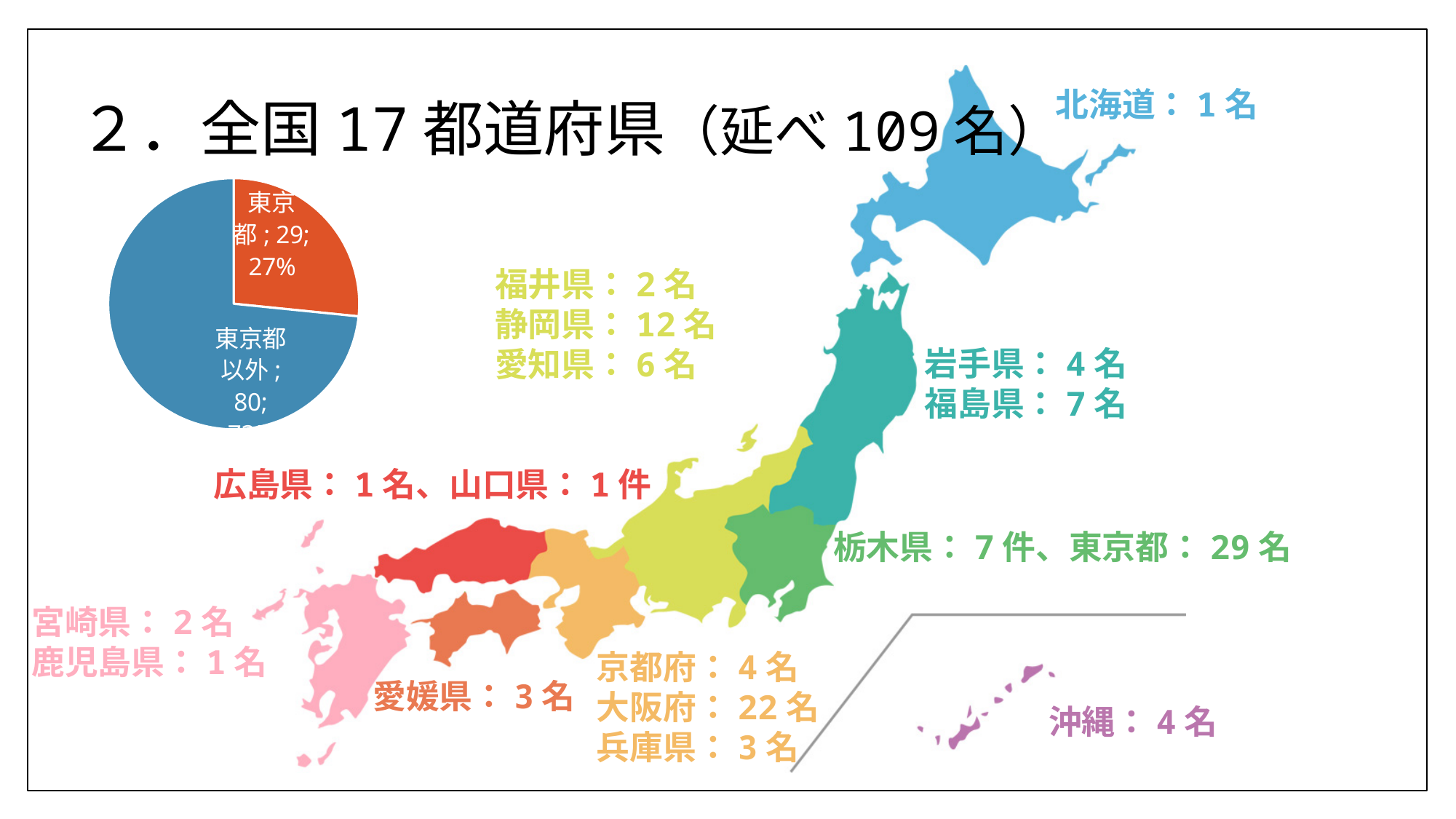
What is the total of the two values shown in the pie chart? 109 Which slice of the pie chart is the largest? 東京都以外 What kind of chart is shown on the left of the slide? pie chart In the pie chart, what is the value for 東京都以外? 80 In the pie chart, which is larger: 東京都 or 東京都以外? 東京都以外 In the pie chart, what is the value for 東京都? 29 Which slice of the pie chart is the smallest? 東京都 In the pie chart, what share of the pie does 東京都 represent? 27% How many slices does the pie chart have? 2 What colour is the 東京都 slice in the pie chart? orange In the pie chart, what is the difference between the value for 東京都以外 and the value for 東京都? 51 On the map, what is the value shown for 大阪府? 22名